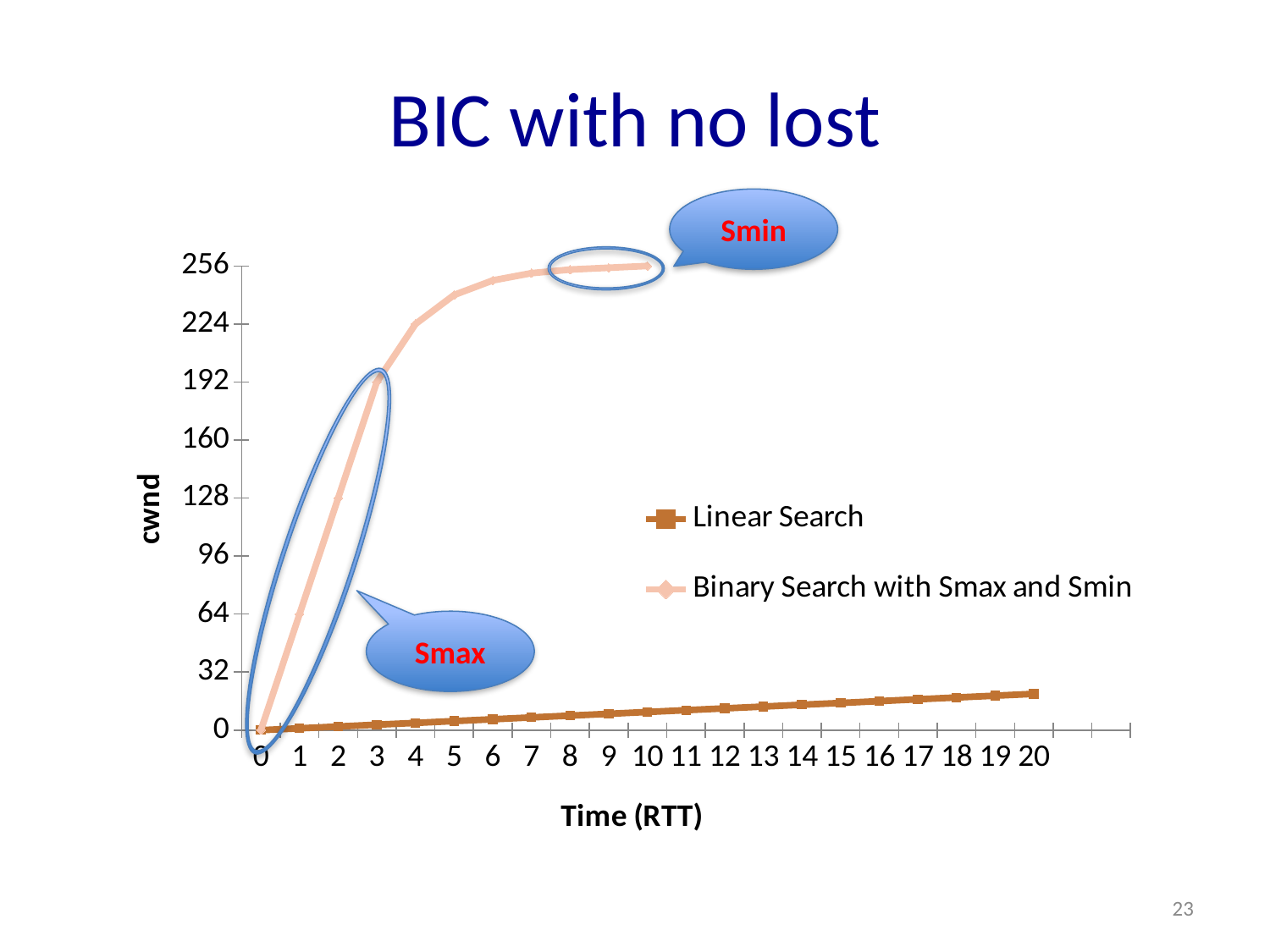
What is the cwnd value of the Binary Search with Smax and Smin series at time 2 RTT? 128 Is the cwnd value for Binary Search with Smax and Smin at time 5 RTT greater or less than 224? greater At time 5 RTT, which series has the higher cwnd value? Binary Search with Smax and Smin Does the Linear Search series rise or fall as time increases? rise What kind of chart is shown on the slide? line chart Is the cwnd value for Linear Search at time 20 RTT greater or less than 32? less What are the two series named in the legend? Linear Search; Binary Search with Smax and Smin What is the cwnd value of the Binary Search with Smax and Smin series at time 3 RTT? 192 How many series does the legend list? 2 What is the cwnd value of the Binary Search with Smax and Smin series at time 1 RTT? 64 Which series reaches the highest cwnd value on the chart? Binary Search with Smax and Smin What is the title of the x axis? Time (RTT)